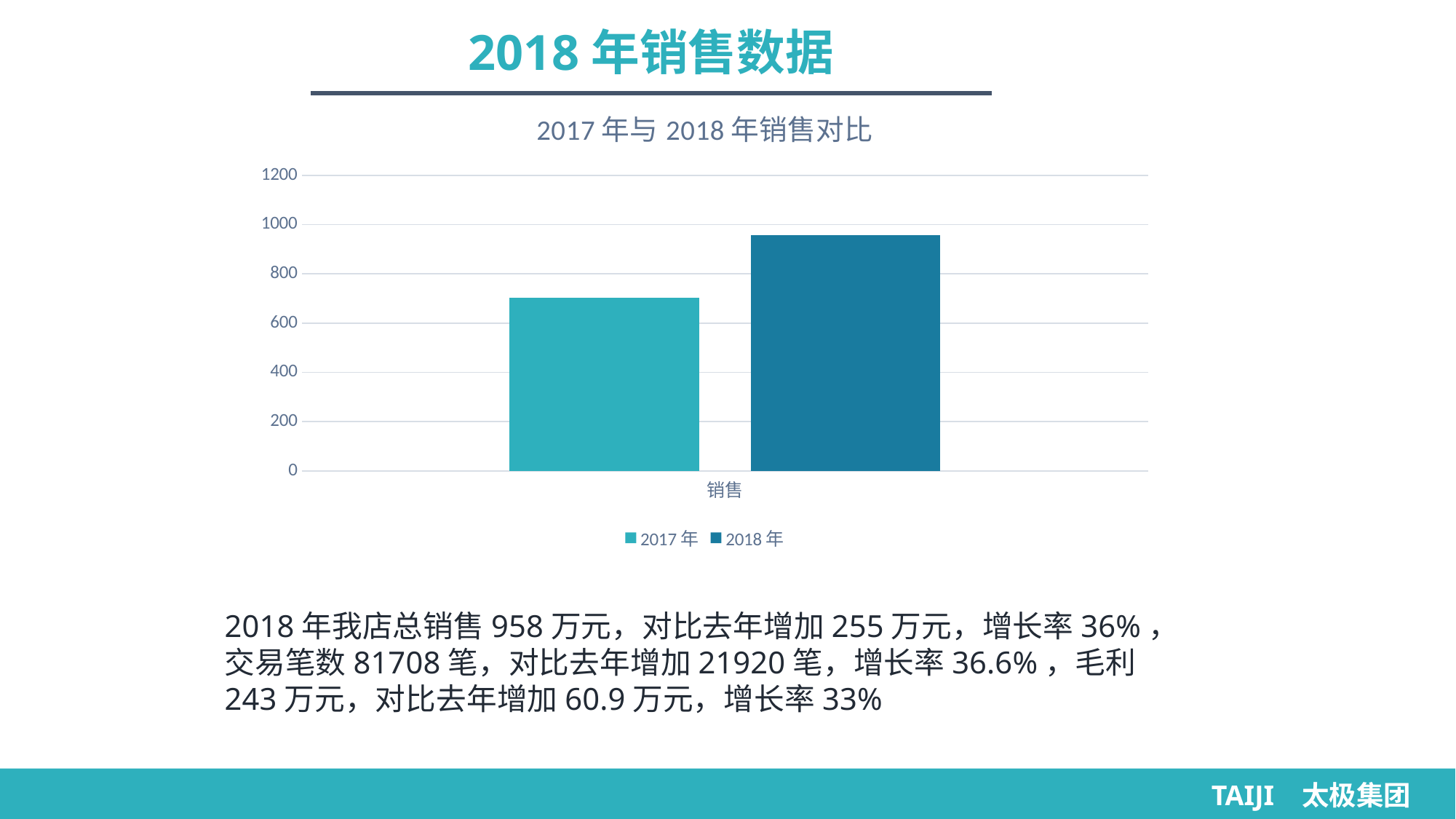
What is the label of the category on the x axis? 销售 What is the title of the chart? 2017 年与 2018 年销售对比 Which series has the higher bar in the chart? 2018 年 Is the value for 2017 年 greater or less than 600? greater How many series does the chart legend list? 2 Which series has the lower bar in the chart? 2017 年 Is the 2018 年 bar larger or smaller than the 2017 年 bar? larger Is the value for 2017 年 greater or less than 800? less Is the value for 2018 年 greater or less than 800? greater What kind of chart is shown on the slide? bar chart How many categories are shown on the x axis of the chart? 1 According to the slide, what was the total sales for 2018 年 (in 万元)? 958 万元